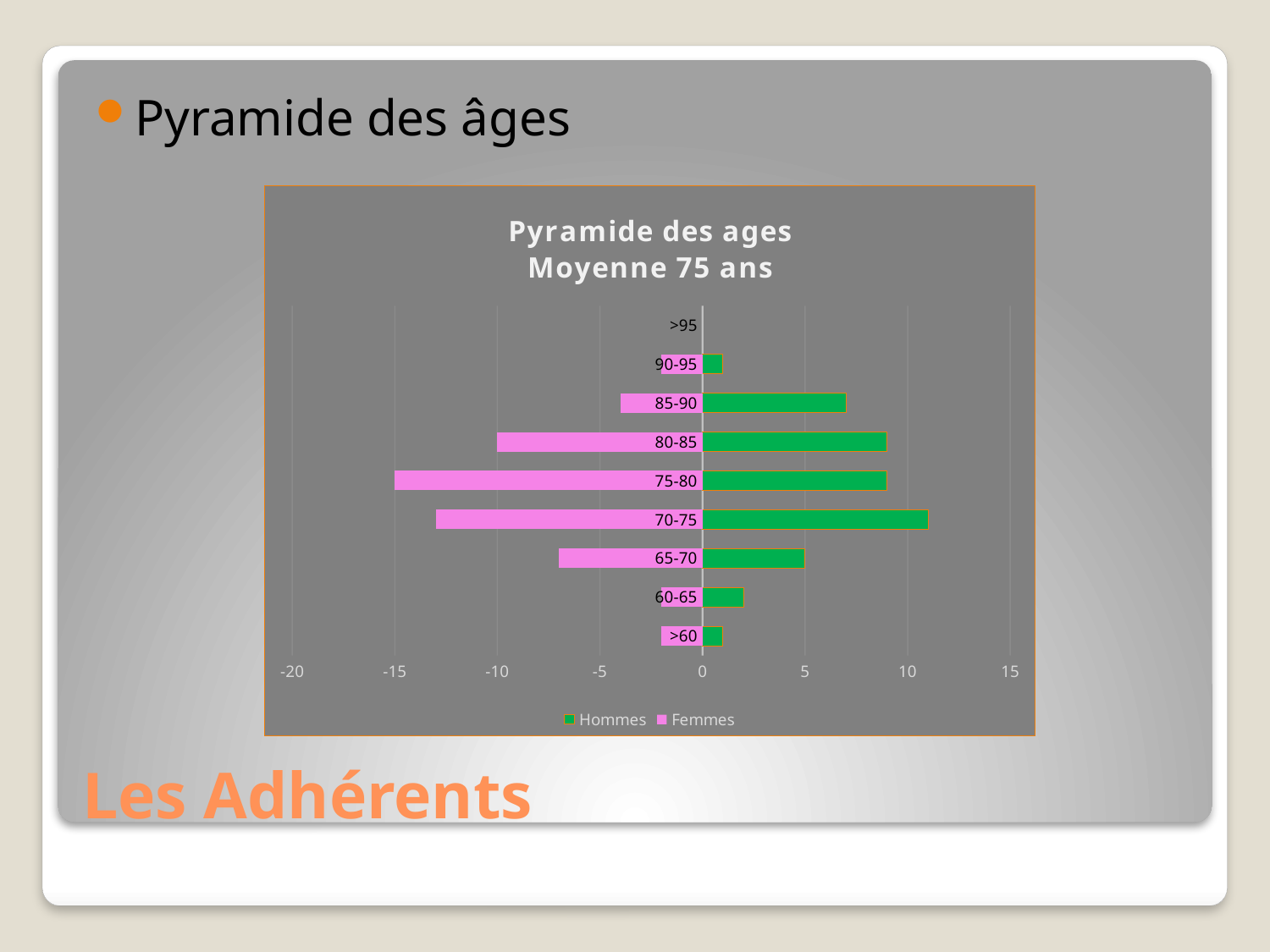
Which age category has the longest Femmes bar? 75-80 What are the two series named in the legend? Hommes and Femmes How many age categories are shown on the vertical axis? 9 What kind of chart is shown on the slide? bar chart Is the Hommes value for 85-90 greater or less than 10? less Does the Femmes bar for 70-75 extend beyond -10 on the axis? yes How many series does the legend list? 2 What is the title of the chart? Pyramide des ages Moyenne 75 ans Which is longer, the Hommes bar for 80-85 or the Hommes bar for 60-65? 80-85 Which is longer, the Femmes bar for 75-80 or the Femmes bar for 85-90? 75-80 Which age category has the longest Hommes bar? 70-75 Is the Hommes value for 70-75 greater or less than 10? greater